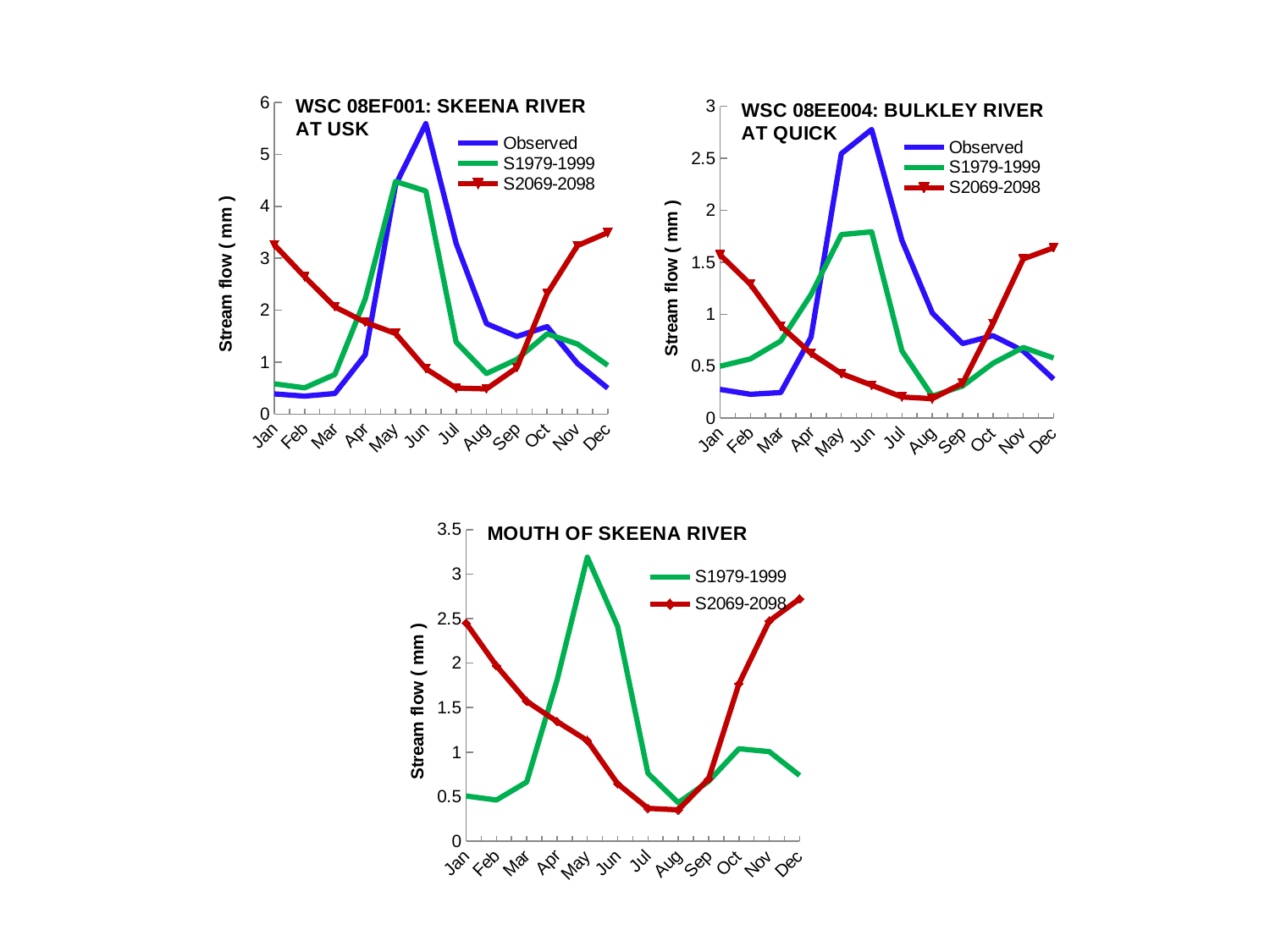
On the WSC 08EF001: SKEENA RIVER AT USK chart, is the Observed value for Jun greater or less than 5? greater How many series does the legend list on the WSC 08EE004: BULKLEY RIVER AT QUICK chart? 3 On the WSC 08EE004: BULKLEY RIVER AT QUICK chart, which series has the lowest value in Jun? S2069-2098 On the WSC 08EE004: BULKLEY RIVER AT QUICK chart, is the S2069-2098 value for Jan greater or less than 1? greater On the MOUTH OF SKEENA RIVER chart, in which month does the S1979-1999 series reach its highest value? May On the MOUTH OF SKEENA RIVER chart, which series has the larger value in Jan, S1979-1999 or S2069-2098? S2069-2098 How many series does the legend list on the WSC 08EF001: SKEENA RIVER AT USK chart? 3 On the WSC 08EF001: SKEENA RIVER AT USK chart, does the S2069-2098 series rise or fall from Jan to Jul? fall On the WSC 08EF001: SKEENA RIVER AT USK chart, in which month does the Observed series reach its highest value? Jun On the WSC 08EE004: BULKLEY RIVER AT QUICK chart, in which month does the Observed series reach its highest value? Jun What kind of chart is the WSC 08EF001: SKEENA RIVER AT USK chart? line chart How many series does the legend list on the MOUTH OF SKEENA RIVER chart? 2